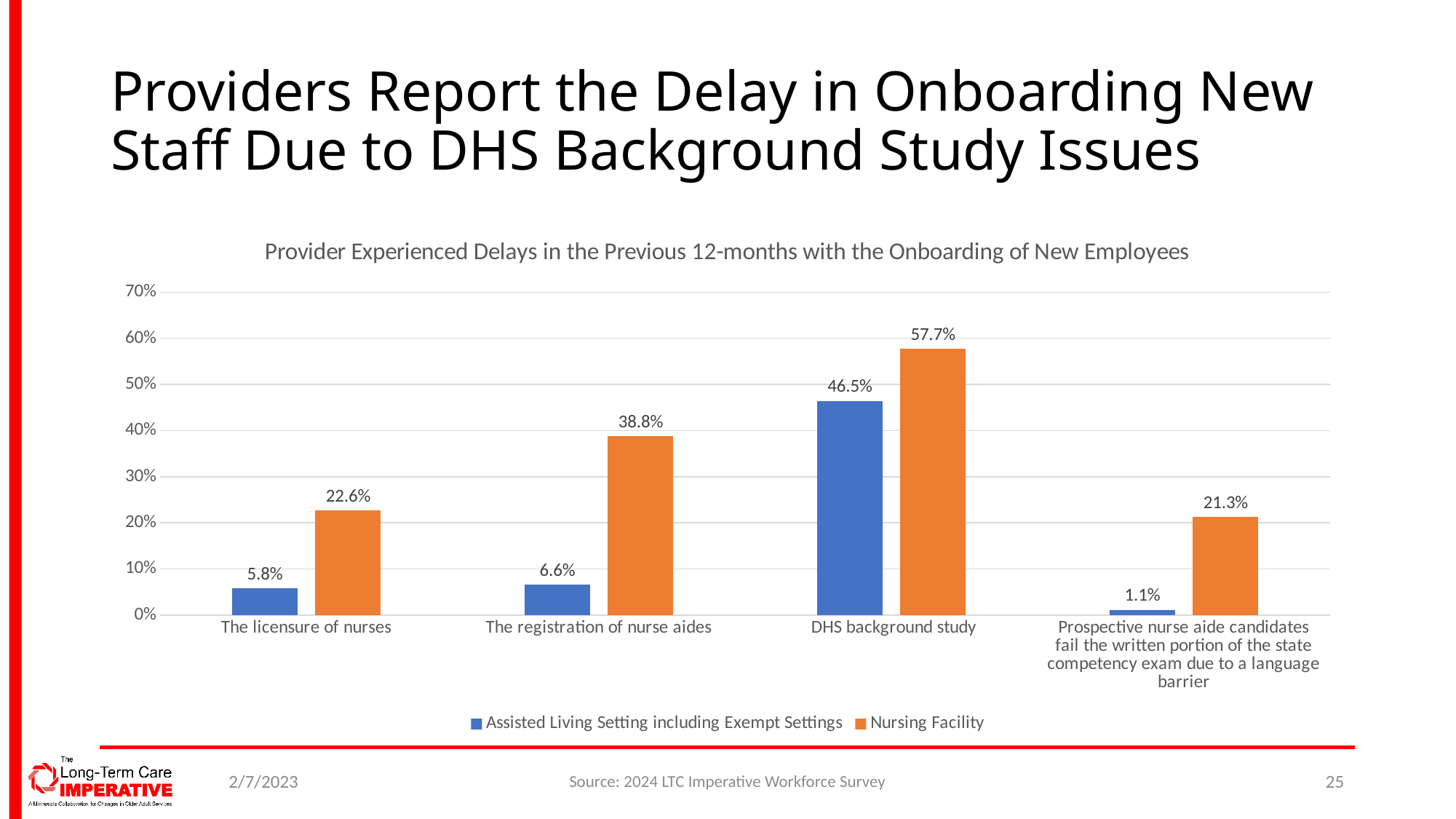
What is the title of the chart? Provider Experienced Delays in the Previous 12-months with the Onboarding of New Employees What kind of chart is shown on the slide? Bar chart Which category has the highest Assisted Living Setting including Exempt Settings value? DHS background study Which is larger for The registration of nurse aides: the Assisted Living Setting including Exempt Settings value or the Nursing Facility value? Nursing Facility What is the Nursing Facility value for DHS background study? 57.7% How many categories are shown on the x axis? 4 What is the Nursing Facility value for The licensure of nurses? 22.6% How many series does the legend list? 2 Is the Nursing Facility value for The registration of nurse aides greater or less than 30%? greater Which category has the lowest Nursing Facility value? Prospective nurse aide candidates fail the written portion of the state competency exam due to a language barrier What is the difference between the Nursing Facility and Assisted Living Setting including Exempt Settings values for DHS background study? 11.2% What is the Assisted Living Setting including Exempt Settings value for The registration of nurse aides? 6.6%